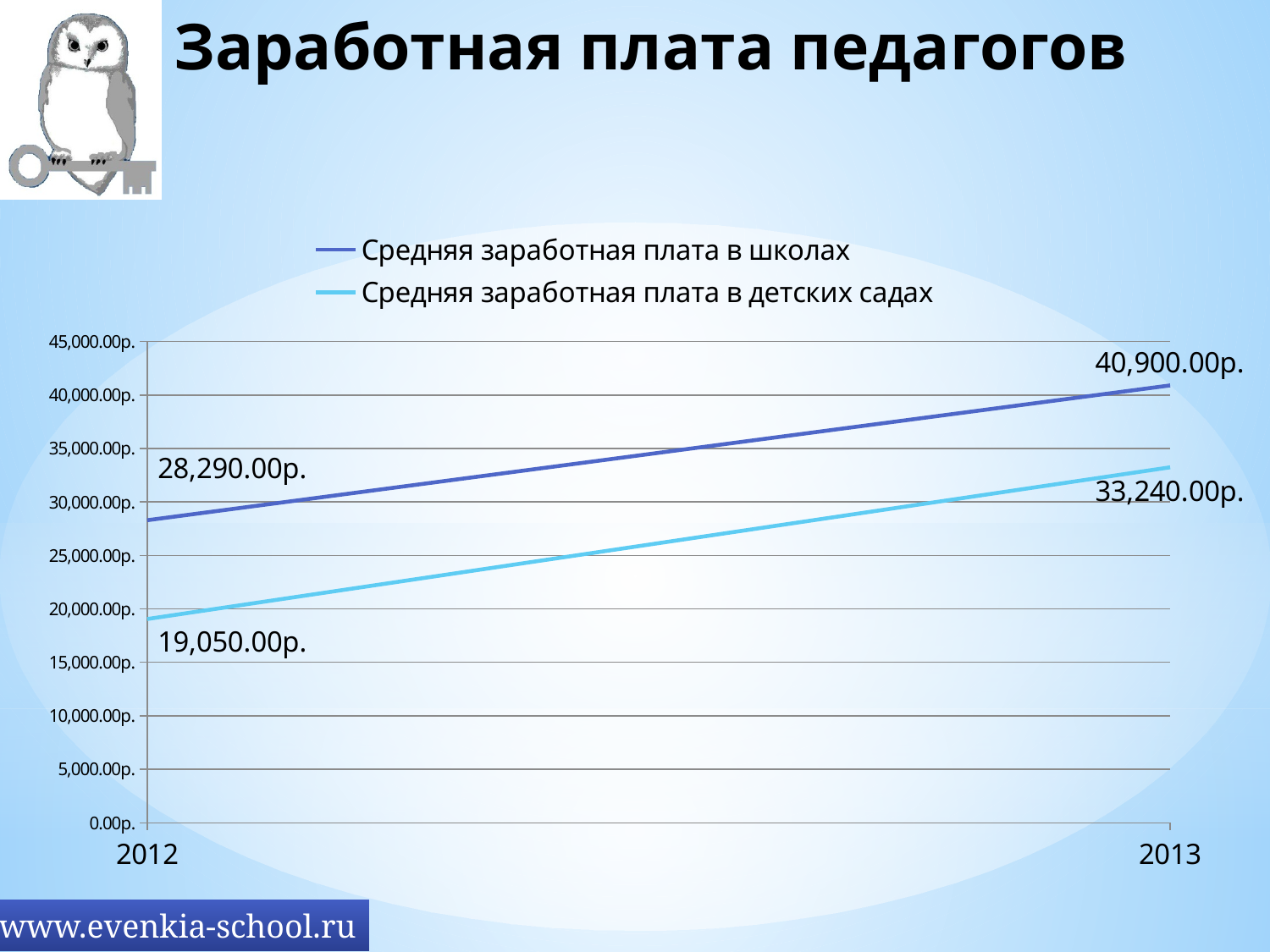
By how much did the average salary in kindergartens increase from 2012 to 2013? 14,190.00р. What is the difference between the average salary in schools and in kindergartens in 2013? 7,660.00р. What type of chart is shown on the slide? line chart What is the average salary in schools (Средняя заработная плата в школах) in 2013? 40,900.00р. How many years are shown on the x axis? 2 What is the average salary in schools (Средняя заработная плата в школах) in 2012? 28,290.00р. Do the values for the kindergarten series rise or fall from 2012 to 2013? rise How many series does the legend list? 2 What is the average salary in kindergartens (Средняя заработная плата в детских садах) in 2013? 33,240.00р. By how much did the average salary in schools increase from 2012 to 2013? 12,610.00р. What is the average salary in kindergartens (Средняя заработная плата в детских садах) in 2012? 19,050.00р. Which series has the higher value in 2012: schools or kindergartens? Средняя заработная плата в школах